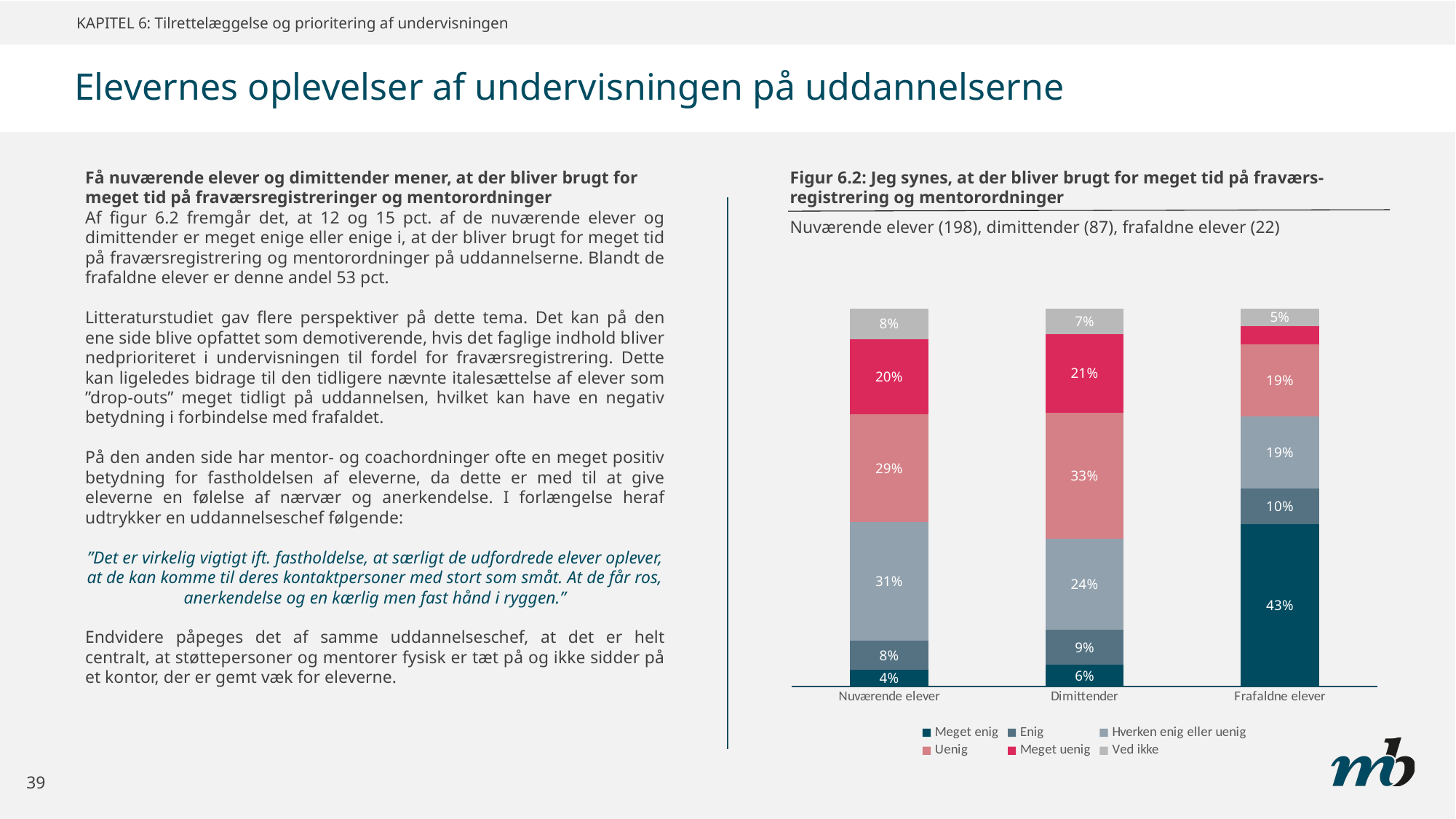
Which legend entry in Figur 6.2 is shown in the darkest colour? Meget enig How many categories are shown on the x axis of Figur 6.2? 3 What is the 'Uenig' value for Dimittender in Figur 6.2? 33% What is the 'Hverken enig eller uenig' value for Nuværende elever in Figur 6.2? 31% In Figur 6.2, is the 'Enig' value larger for Dimittender or for Nuværende elever? Dimittender What is the 'Meget enig' value for Frafaldne elever in Figur 6.2? 43% How many series does the legend of Figur 6.2 list? 6 Which category has the highest 'Meget enig' value in Figur 6.2? Frafaldne elever What kind of chart is shown in Figur 6.2? Stacked bar chart In Figur 6.2, what is the difference between the 'Meget enig' values for Frafaldne elever and Nuværende elever? 39 percentage points Which category has the lowest 'Ved ikke' value in Figur 6.2? Frafaldne elever In Figur 6.2, what is the total of the 'Meget enig' and 'Enig' segments for Dimittender? 15%